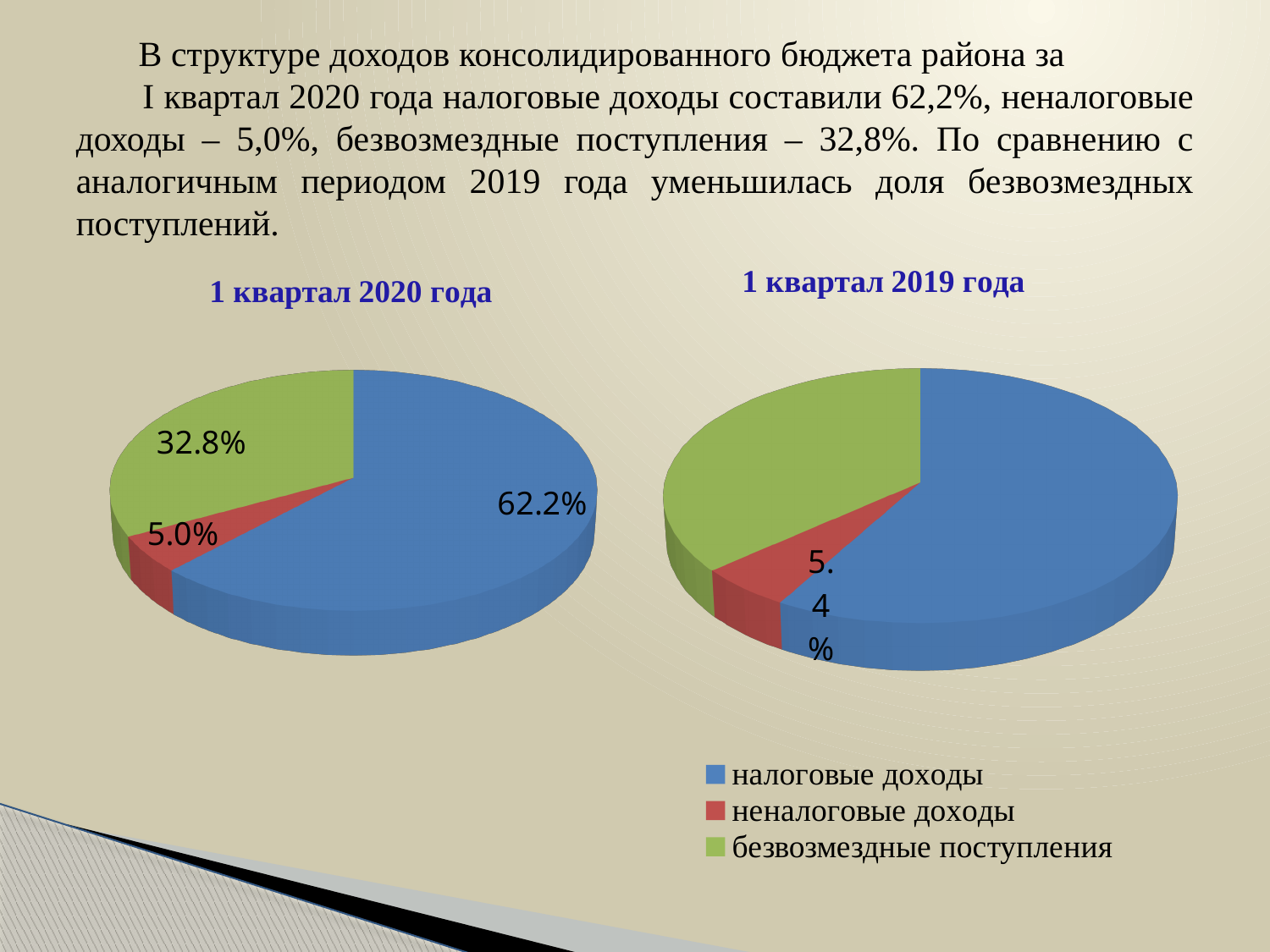
What type of chart is used on the left of the slide, titled "1 квартал 2020 года"? pie chart How many categories does the chart titled "1 квартал 2020 года" show? 3 Which colour represents безвозмездные поступления in the legend? green In the chart titled "1 квартал 2019 года", what share do неналоговые доходы have? 5.4% In the chart titled "1 квартал 2020 года", what share do безвозмездные поступления have? 32.8% In the chart titled "1 квартал 2020 года", what is the difference between the shares of налоговые доходы and безвозмездные поступления? 29.4% In the chart titled "1 квартал 2019 года", which slice is larger: налоговые доходы or безвозмездные поступления? налоговые доходы How many entries does the legend on the slide list? 3 In the chart titled "1 квартал 2020 года", what share do неналоговые доходы have? 5.0% In the chart titled "1 квартал 2020 года", which category has the largest slice? налоговые доходы In the chart titled "1 квартал 2020 года", what share do налоговые доходы have? 62.2% In the chart titled "1 квартал 2020 года", which category has the smallest slice? неналоговые доходы